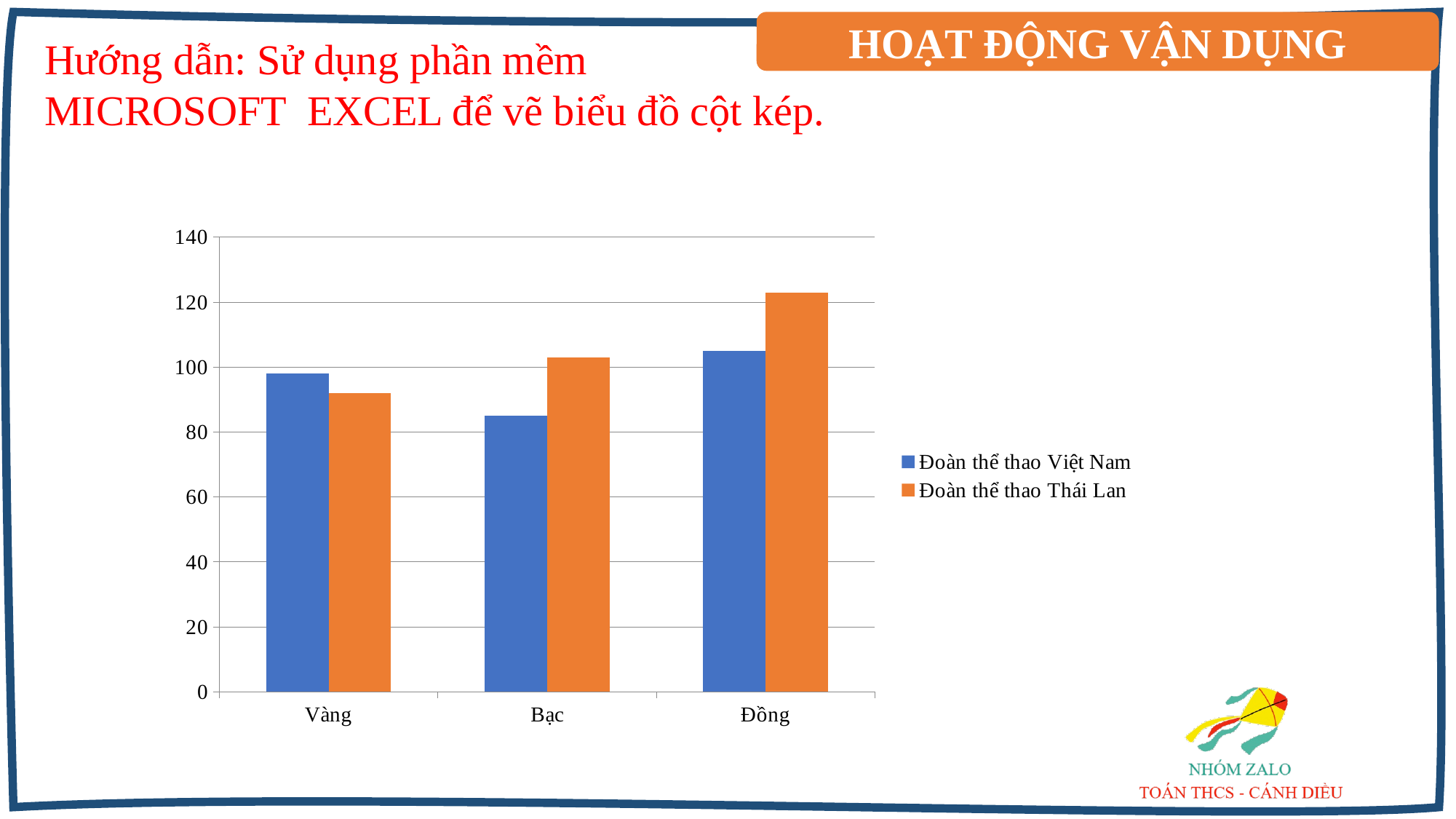
Which category has the lowest value for Đoàn thể thao Thái Lan? Vàng For the Bạc category, which series has the larger value: Đoàn thể thao Việt Nam or Đoàn thể thao Thái Lan? Đoàn thể thao Thái Lan Is the value for Đoàn thể thao Việt Nam in the Bạc category greater or less than 100? less How many series does the chart's legend list? 2 How many categories are shown on the x axis of the chart? 3 For the Đồng category, which series has the larger value: Đoàn thể thao Việt Nam or Đoàn thể thao Thái Lan? Đoàn thể thao Thái Lan Which category has the lowest value for Đoàn thể thao Việt Nam? Bạc Which series is shown in orange in the chart? Đoàn thể thao Thái Lan What kind of chart is shown on the slide? bar chart Which category has the highest value for Đoàn thể thao Thái Lan? Đồng For the Vàng category, which series has the larger value: Đoàn thể thao Việt Nam or Đoàn thể thao Thái Lan? Đoàn thể thao Việt Nam Is the value for Đoàn thể thao Thái Lan in the Đồng category greater or less than 120? greater